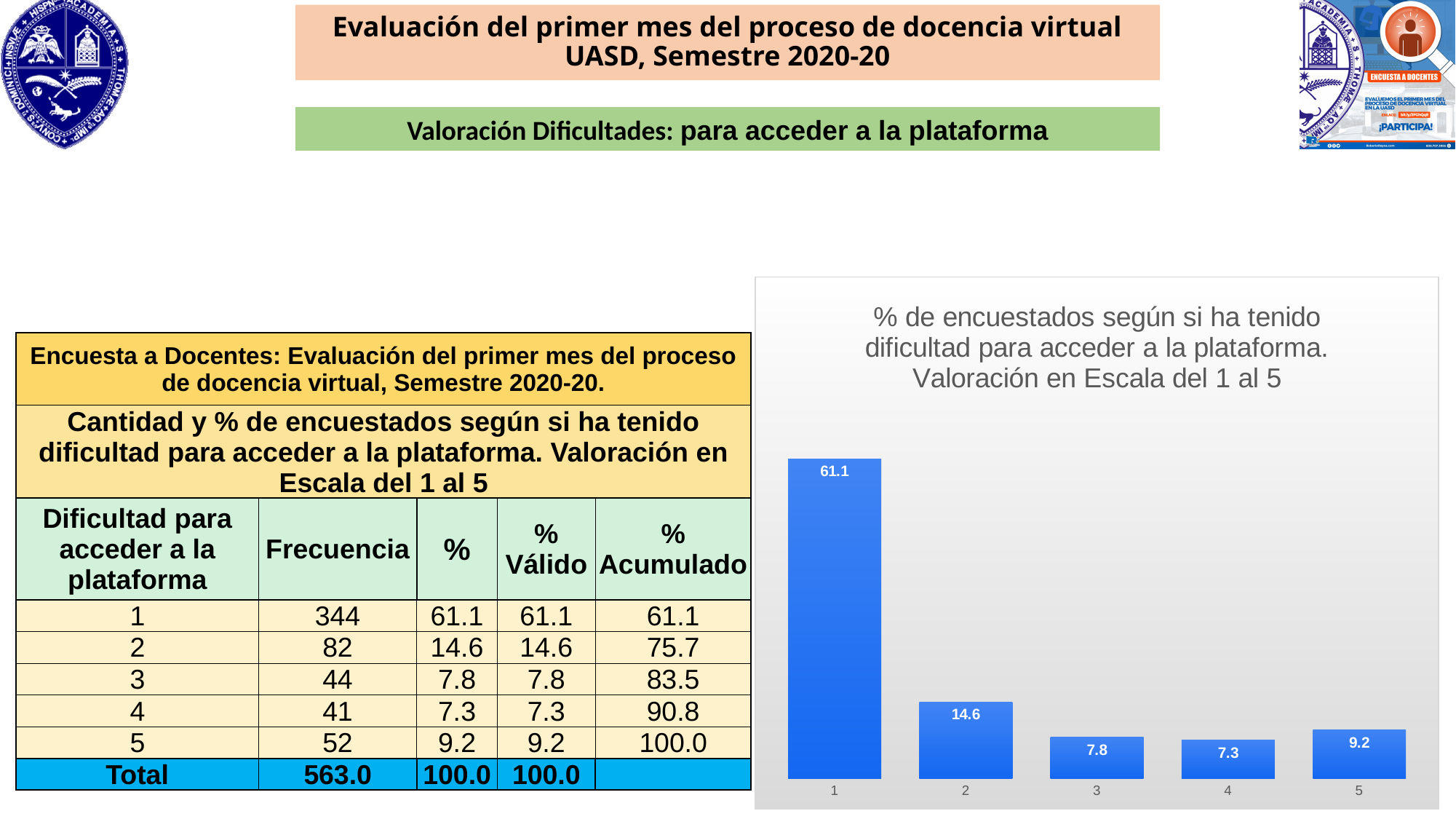
What is the value shown for category 5 in the chart? 9.2 Which is larger in the chart, the value for category 2 or the value for category 5? 2 What kind of chart is shown on the slide? bar chart Do the values in the chart rise or fall from category 1 to category 4? fall What is the value shown for category 1 in the chart? 61.1 What is the value shown for category 3 in the chart? 7.8 What colour are the bars in the chart? blue Which category has the highest value in the chart? 1 What is the title of the chart? % de encuestados según si ha tenido dificultad para acceder a la plataforma. Valoración en Escala del 1 al 5 What is the difference between the values for category 1 and category 2 in the chart? 46.5 How many categories are plotted in the chart? 5 Which category has the lowest value in the chart? 4